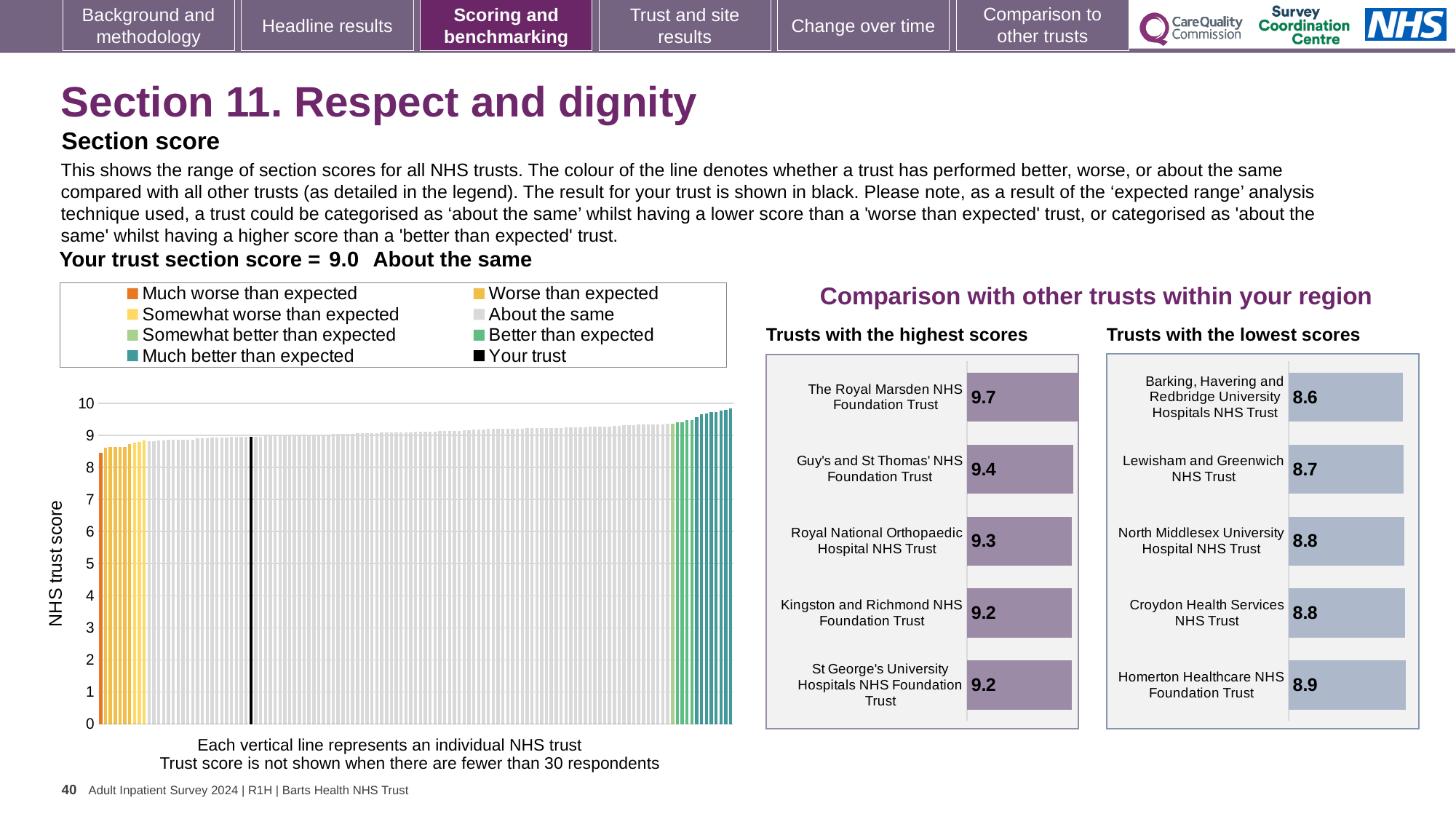
In the 'Trusts with the lowest scores' chart, which has the higher score: Croydon Health Services NHS Trust or Homerton Healthcare NHS Foundation Trust? Homerton Healthcare NHS Foundation Trust In the large chart on the left, is the value for the lowest-scoring trust greater or less than 8? greater In the 'Trusts with the highest scores' chart, what is the score for The Royal Marsden NHS Foundation Trust? 9.7 In the 'Trusts with the lowest scores' chart, what is the difference between the scores of Homerton Healthcare NHS Foundation Trust and Barking, Havering and Redbridge University Hospitals NHS Trust? 0.3 In the 'Trusts with the highest scores' chart, which trust has the highest score? The Royal Marsden NHS Foundation Trust In the 'Trusts with the lowest scores' chart, what is the score for Lewisham and Greenwich NHS Trust? 8.7 In the 'Trusts with the lowest scores' chart, which trust has the lowest score? Barking, Havering and Redbridge University Hospitals NHS Trust In the 'Trusts with the highest scores' chart, what is the score for Royal National Orthopaedic Hospital NHS Trust? 9.3 How many trusts are shown in the 'Trusts with the highest scores' chart? 5 How many entries does the legend of the large chart on the left list? 8 In the 'Trusts with the highest scores' chart, what is the difference between the scores of The Royal Marsden NHS Foundation Trust and Guy's and St Thomas' NHS Foundation Trust? 0.3 In the large chart on the left, what is the section score for your trust (the black bar)? 9.0